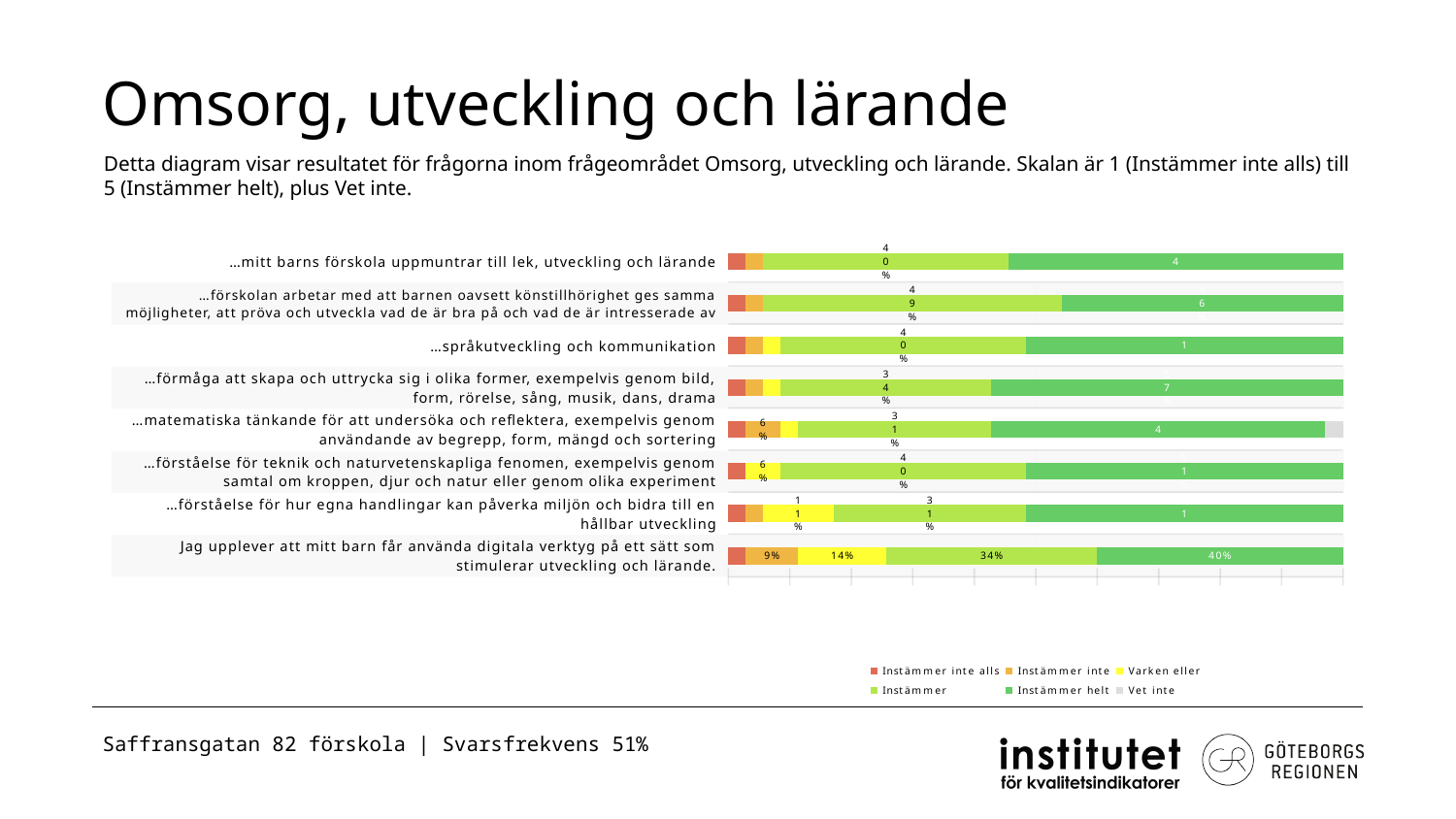
Which response category is listed first in the chart legend? Instämmer inte alls What is the 'Instämmer' value for the statement 'Jag upplever att mitt barn får använda digitala verktyg på ett sätt som stimulerar utveckling och lärande.'? 34% What is the 'Instämmer helt' value for the statement 'Jag upplever att mitt barn får använda digitala verktyg på ett sätt som stimulerar utveckling och lärande.'? 40% For the statement about digital tools ('Jag upplever att mitt barn får använda digitala verktyg...'), which response category has the largest share? Instämmer helt What kind of chart is shown on the slide? Stacked bar chart Which response category is shown in grey in the chart legend? Vet inte How many series does the chart legend list? 6 What is the 'Varken eller' value for the statement 'Jag upplever att mitt barn får använda digitala verktyg på ett sätt som stimulerar utveckling och lärande.'? 14% How many statements (bars) are plotted in the chart? 8 For the statement about digital tools ('Jag upplever att mitt barn får använda digitala verktyg...'), which is larger: the 'Instämmer' share or the 'Instämmer helt' share? Instämmer helt For the statement about digital tools ('Jag upplever att mitt barn får använda digitala verktyg...'), what is the difference between the 'Instämmer helt' share (40%) and the 'Instämmer' share (34%)? 6%